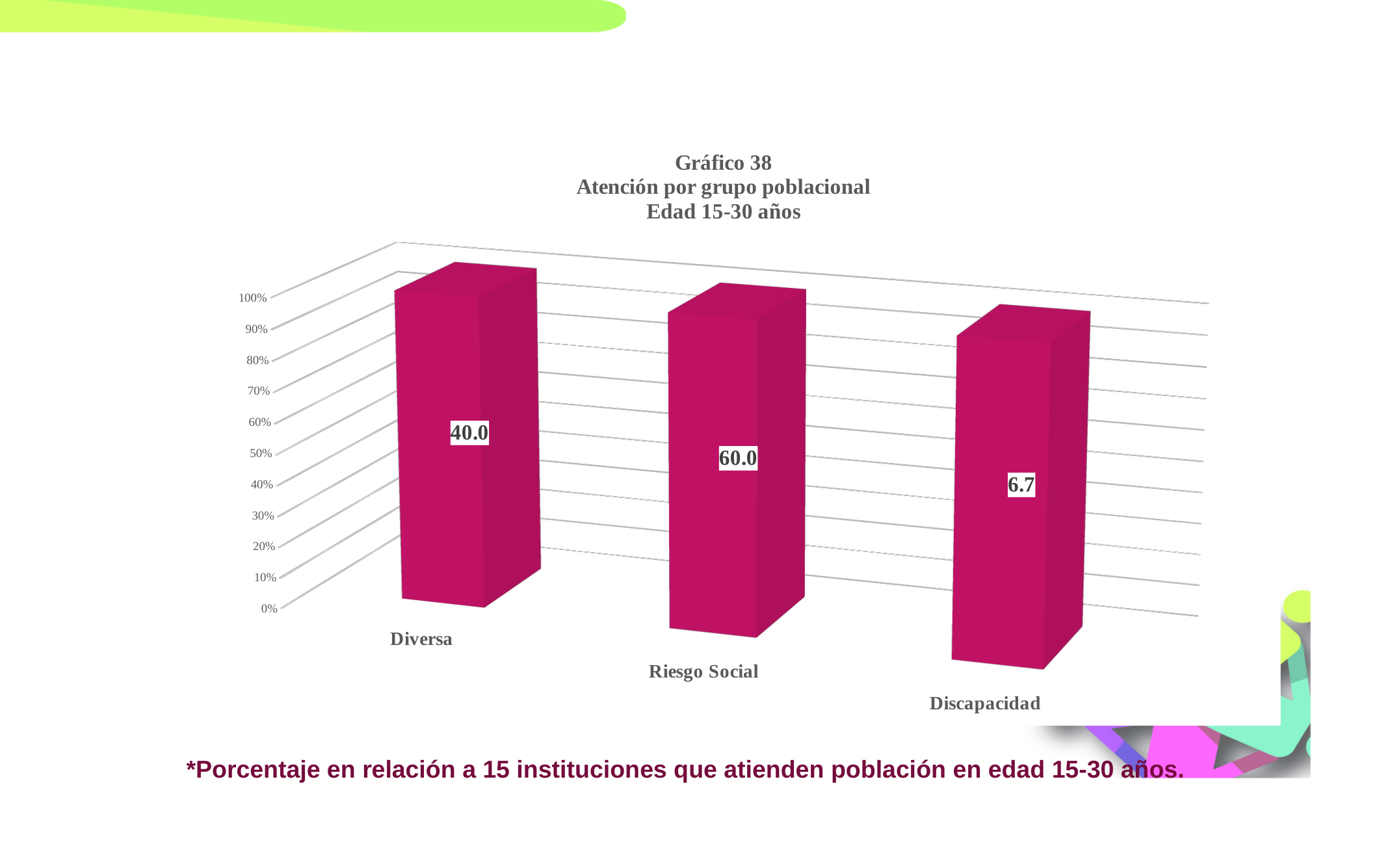
What is the value shown for Riesgo Social? 60.0 What is the difference between the values for Riesgo Social and Diversa? 20.0 Which category has the highest value? Riesgo Social Which is larger, the value for Diversa or the value for Discapacidad? Diversa What kind of chart is shown on the slide? Bar chart What is the value shown for Discapacidad? 6.7 What is the highest value labelled on the vertical axis? 100% How many categories are shown in the chart? 3 What is the value shown for Diversa? 40.0 What is the difference between the values for Diversa and Discapacidad? 33.3 What is the title of the chart? Gráfico 38 Atención por grupo poblacional Edad 15-30 años Which category has the lowest value? Discapacidad